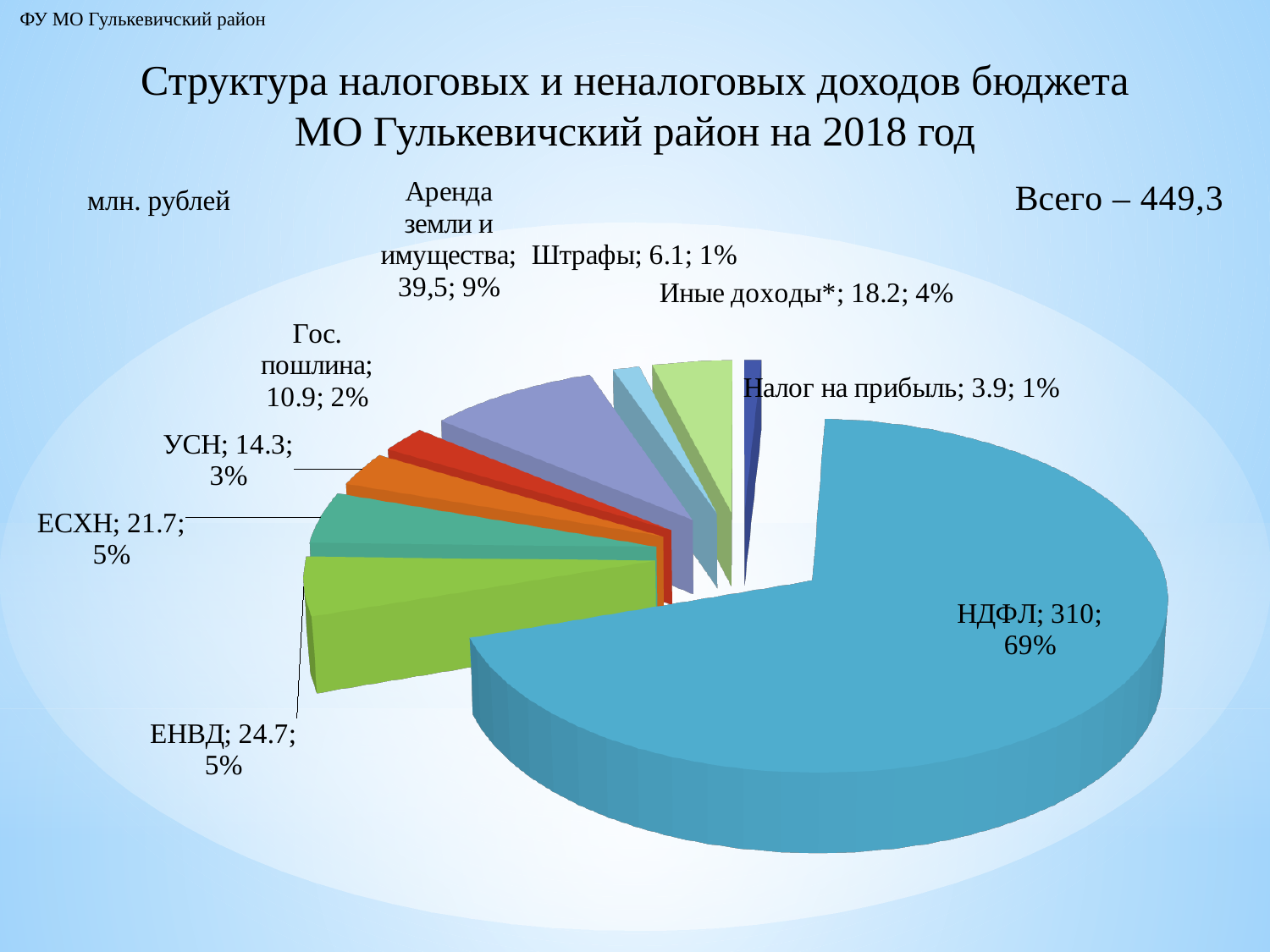
What is the value for Аренда земли и имущества? 39,5 Which category has the smallest value? Налог на прибыль What share of the pie does НДФЛ take? 69% What is the difference between the values for ЕНВД and ЕСХН? 3 Which category has the largest slice? НДФЛ What is the value for ЕНВД? 24.7 What kind of chart is shown on the slide? pie chart What total is stated on the slide for the chart? 449,3 What share of the pie does Иные доходы* take? 4% How many slices does the pie chart have? 9 What is the value for НДФЛ? 310 Which is larger, the value for УСН or the value for Гос. пошлина? УСН